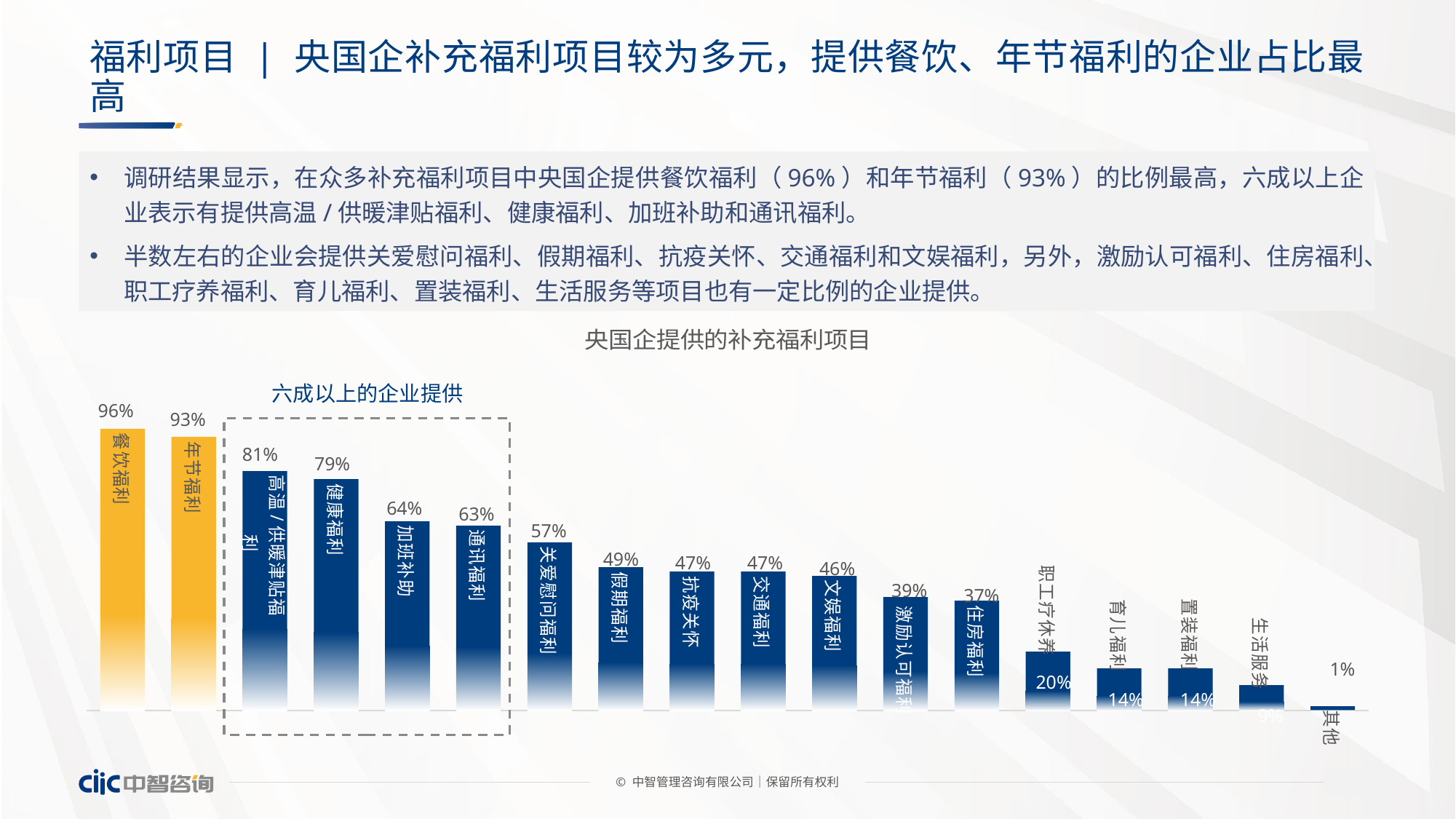
What is the difference between the values for 餐饮福利 and 年节福利? 3% What is the value for 餐饮福利 in the chart 央国企提供的补充福利项目? 96% Which category has the lowest value in the chart? 其他 What kind of chart is shown on the slide? Bar chart How many categories are shown in the chart? 18 Which is larger, the value for 关爱慰问福利 or the value for 假期福利? 关爱慰问福利 What is the difference between the values for 高温/供暖津贴福利 and 通讯福利? 18% Which category has the highest value in the chart? 餐饮福利 What is the value for 职工疗休养 in the chart? 20% What is the value for 健康福利 in the chart? 79% Do the values rise or fall from left to right along the x axis? Fall What is the value for 住房福利 in the chart? 37%